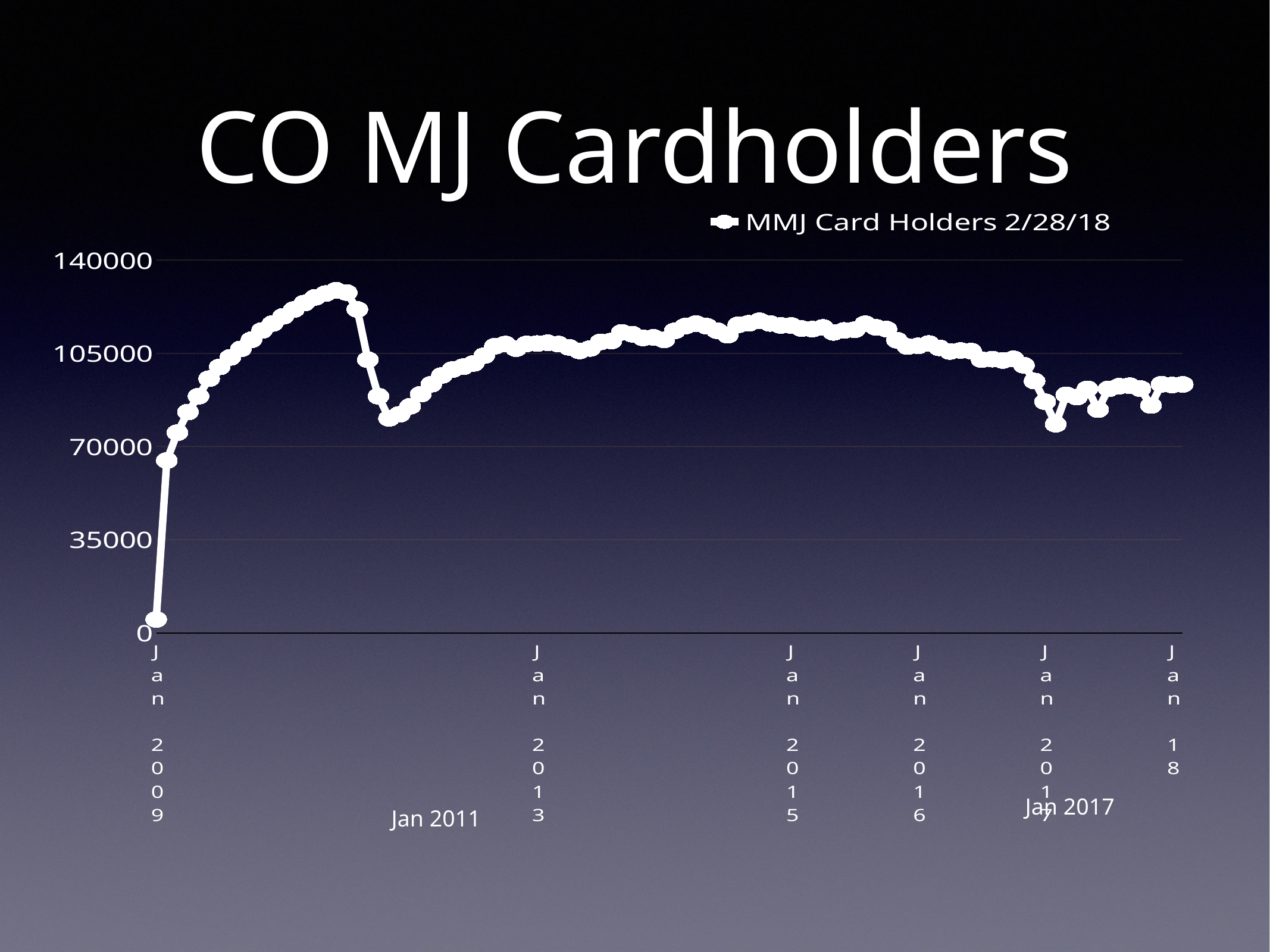
Do the values rise or fall between Jan 2016 and Jan 2017? fall At which labelled date is the line at its lowest value? Jan 2009 How many series does the legend list? 1 Is the highest point on the line greater or less than 140000? less What kind of chart is shown on the slide? line chart Is the value for Jan 2015 greater or less than 105000? greater Is the value for Jan 2017 greater or less than 105000? less Do the values rise or fall between Jan 2009 and Jan 2011? rise What is the title of the chart? CO MJ Cardholders What is the legend entry for the plotted series? MMJ Card Holders 2/28/18